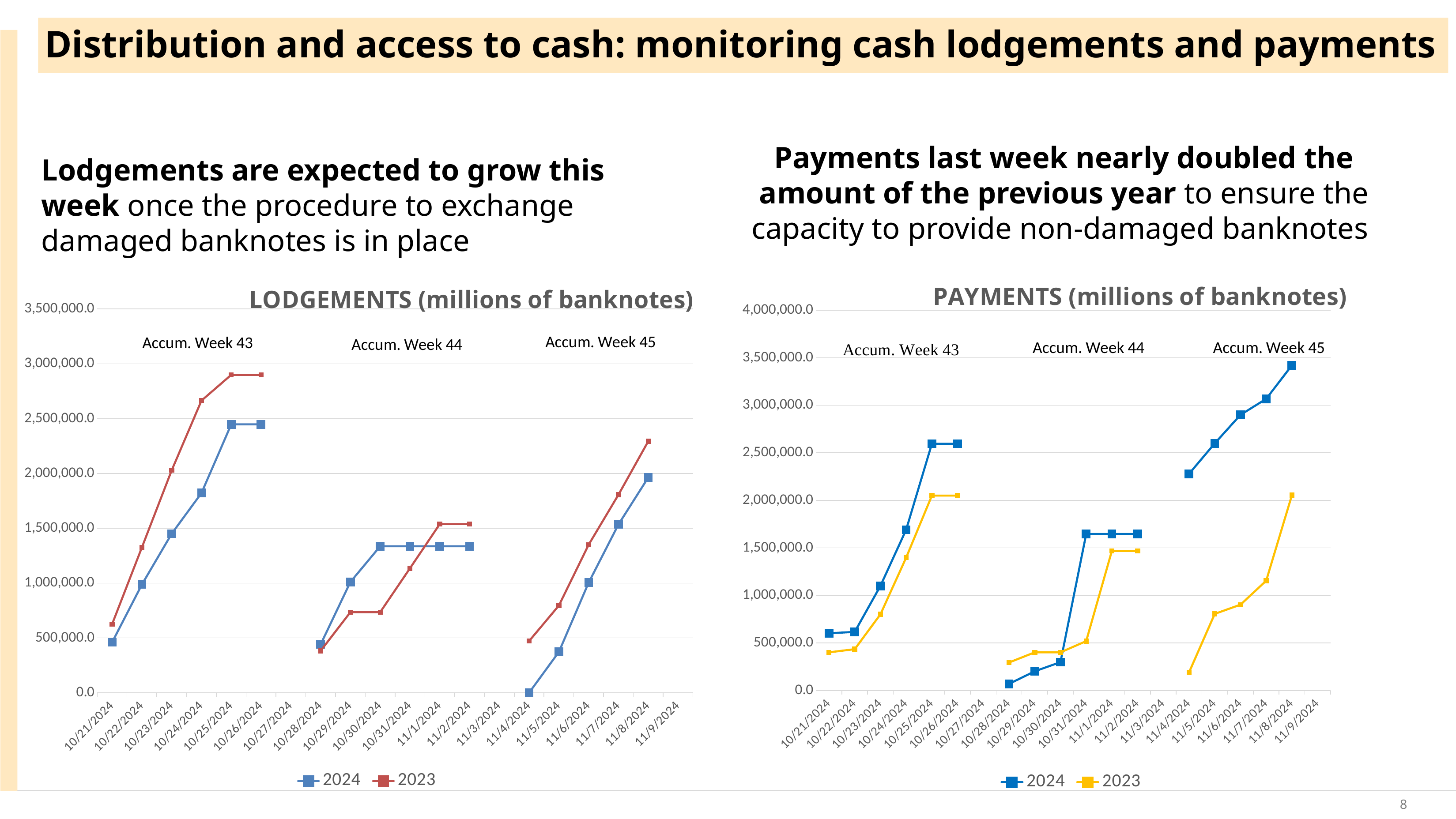
In the PAYMENTS chart, does the 2024 series rise or fall from 11/4/2024 to 11/8/2024? rise In the LODGEMENTS chart, which series is shown in red? 2023 In the LODGEMENTS chart, is the 2024 value on 11/1/2024 greater or less than 1,500,000.0? less How many dates are shown on the x axis of the LODGEMENTS chart? 20 In the LODGEMENTS chart, is the 2023 value on 10/25/2024 greater or less than 2,500,000.0? greater What type of chart is the LODGEMENTS (millions of banknotes) chart? line chart In the PAYMENTS chart, is the 2024 value on 11/8/2024 greater or less than 3,000,000.0? greater In the PAYMENTS chart, which series is shown in yellow? 2023 How many series does the legend of the PAYMENTS (millions of banknotes) chart list? 2 In the LODGEMENTS chart, on 10/25/2024 which series has the larger value, 2024 or 2023? 2023 In the PAYMENTS chart, on 10/25/2024 which series has the larger value, 2024 or 2023? 2024